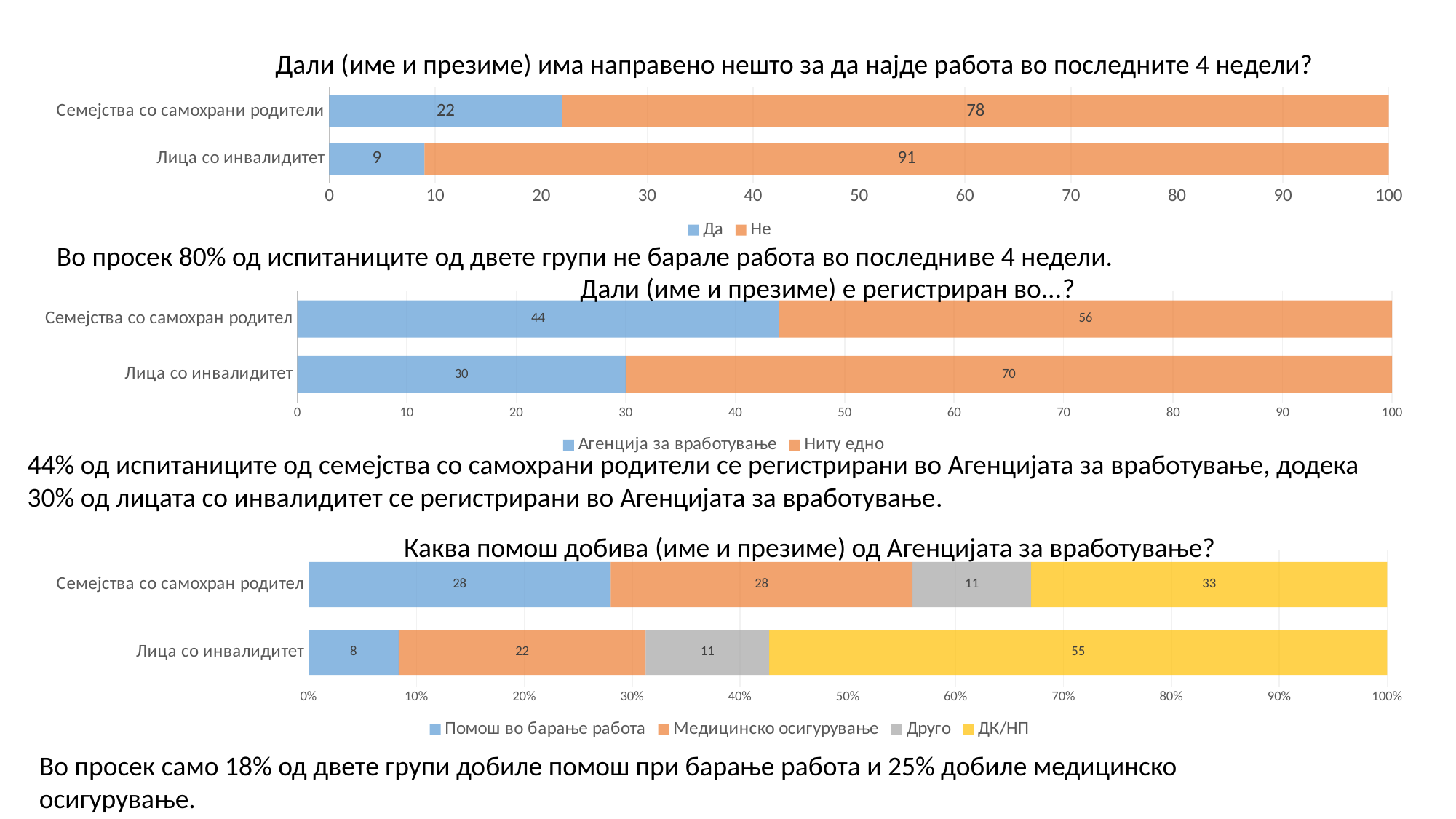
In the bottom chart 'Каква помош добива (име и презиме) од Агенцијата за вработување?', what is the total of the stacked bar for 'Лица со инвалидитет'? 96 In the top chart 'Дали (име и презиме) има направено нешто за да најде работа во последните 4 недели?', what is the value of 'Да' for 'Лица со инвалидитет'? 9 In the bottom chart 'Каква помош добива (име и презиме) од Агенцијата за вработување?', how many series does the legend list? 4 In the bottom chart 'Каква помош добива (име и презиме) од Агенцијата за вработување?', which is larger: 'Медицинско осигурување' for 'Семејства со самохран родител' or for 'Лица со инвалидитет'? Семејства со самохран родител What type of chart is the top chart 'Дали (име и презиме) има направено нешто за да најде работа во последните 4 недели?'? Stacked bar chart In the middle chart 'Дали (име и презиме) е регистриран во...?', what is the value of 'Агенција за вработување' for 'Семејства со самохран родител'? 44 In the middle chart 'Дали (име и презиме) е регистриран во...?', which category has the higher value for 'Ниту едно'? Лица со инвалидитет In the top chart 'Дали (име и презиме) има направено нешто за да најде работа во последните 4 недели?', what is the difference between the 'Не' values for 'Лица со инвалидитет' and 'Семејства со самохрани родители'? 13 In the bottom chart 'Каква помош добива (име и презиме) од Агенцијата за вработување?', what is the value of 'ДК/НП' for 'Лица со инвалидитет'? 55 In the bottom chart 'Каква помош добива (име и презиме) од Агенцијата за вработување?', what is the value of 'Помош во барање работа' for 'Семејства со самохран родител'? 28 In the top chart 'Дали (име ииме) има направено нешто за да најде работа во последните 4 недели?', what is the value of 'Не' for 'Семејства со самохрани родители'? 78 In the middle chart 'Дали (име и презиме) е регистриран во...?', how many series does the legend list? 2